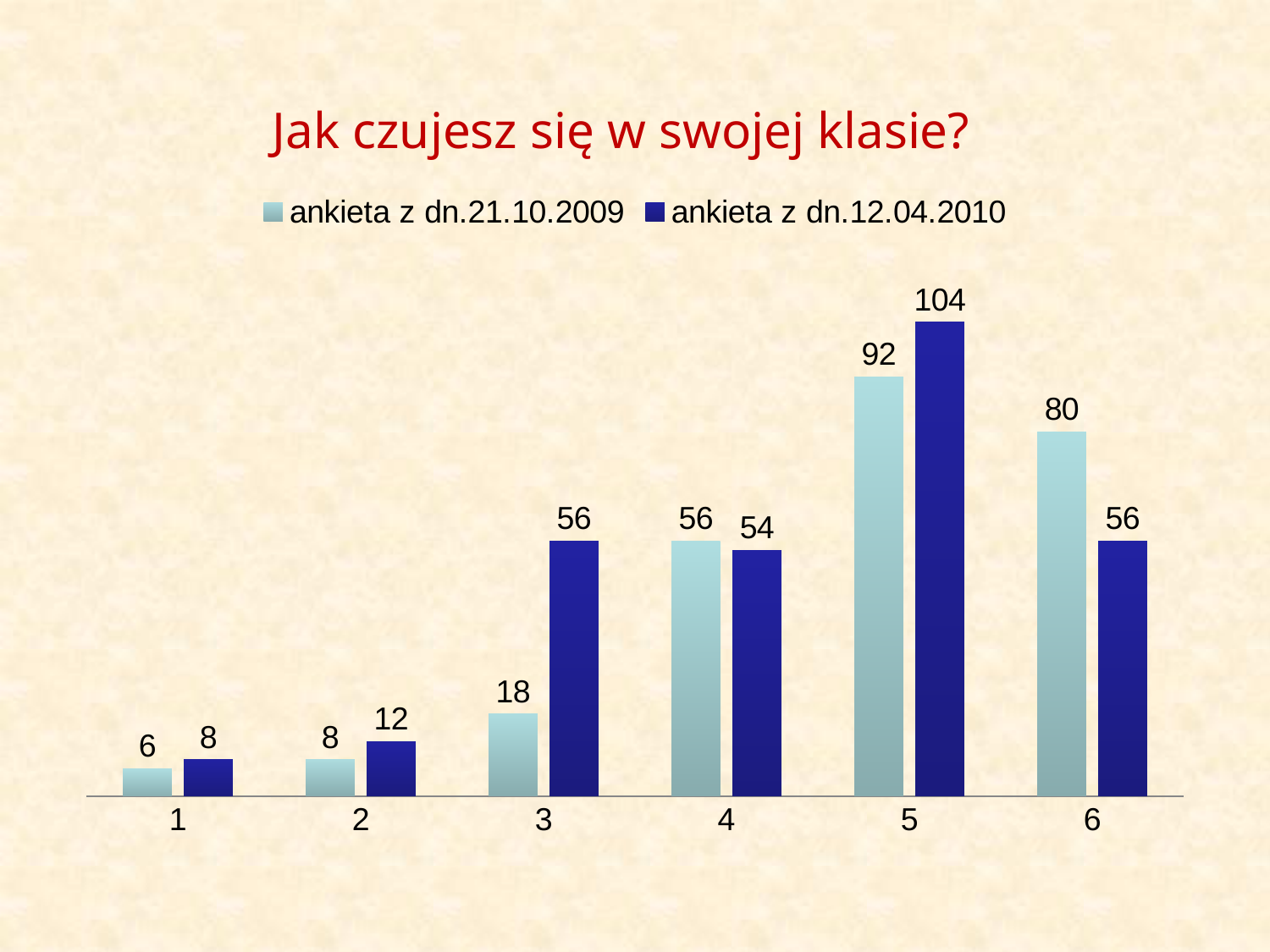
How many categories are shown on the x axis? 6 What is the difference between the two series' values for category 6? 24 What kind of chart is shown on the slide? bar chart For category 4, which series has the larger value? ankieta z dn.21.10.2009 What is the title of the chart? Jak czujesz się w swojej klasie? Which category has the highest value in the 'ankieta z dn.21.10.2009' series? 5 What is the value for category 5 in the 'ankieta z dn.12.04.2010' series? 104 Which category has the lowest value in the 'ankieta z dn.12.04.2010' series? 1 What is the difference between the 'ankieta z dn.12.04.2010' and 'ankieta z dn.21.10.2009' values for category 3? 38 What is the value for category 6 in the 'ankieta z dn.21.10.2009' series? 80 What is the value for category 3 in the 'ankieta z dn.21.10.2009' series? 18 How many series does the legend list? 2